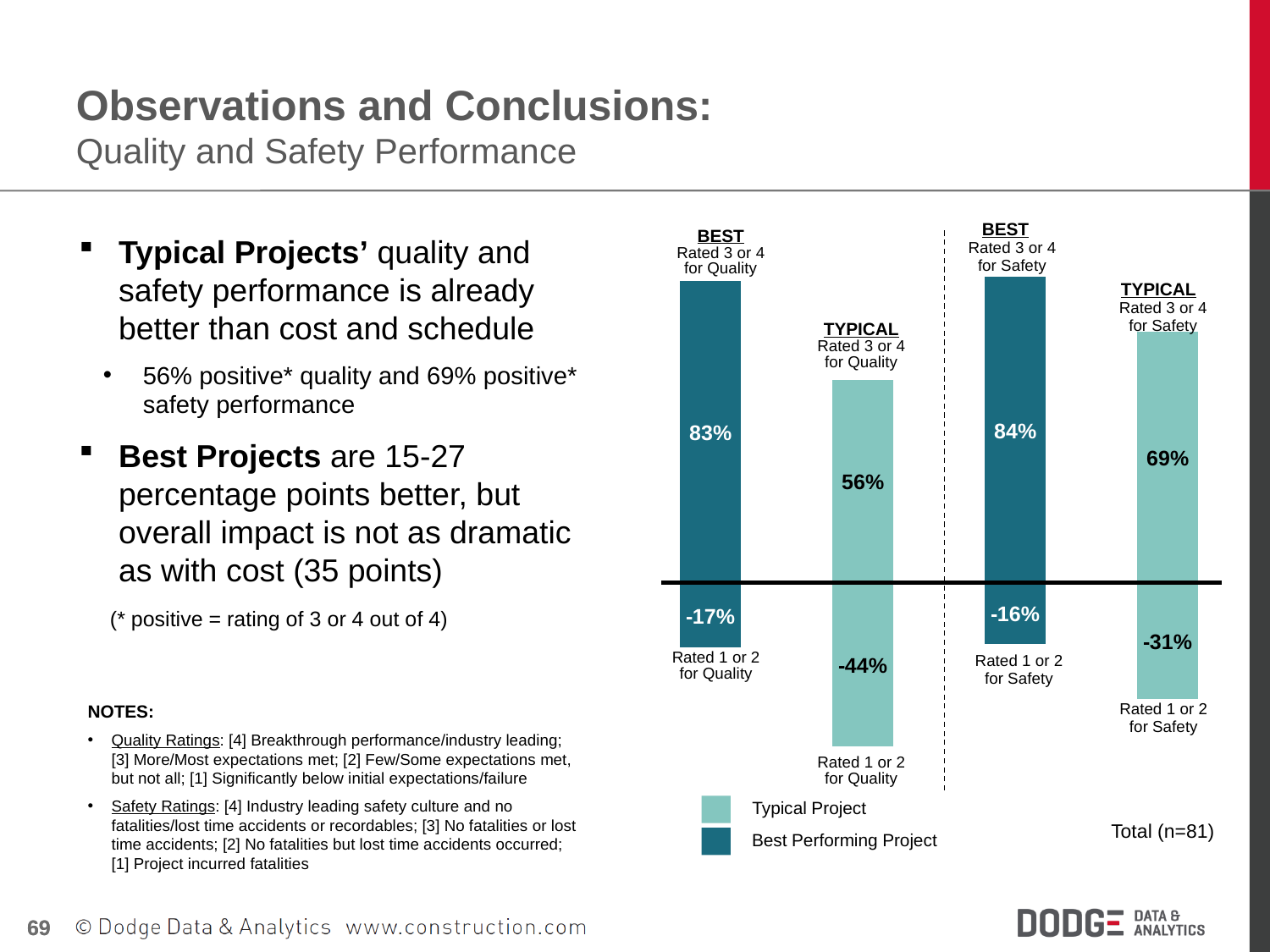
What percentage of Best Performing Projects were rated 3 or 4 for Quality? 83% Which is larger: the percentage of Typical Projects rated 3 or 4 for Safety or for Quality? Safety (69%) Which bar has the highest percentage rated 3 or 4? Best Performing Project for Safety (84%) What is the difference in percentage points between Best Performing and Typical Projects rated 3 or 4 for Quality? 27 percentage points What percentage of Typical Projects were rated 3 or 4 for Quality? 56% How many series does the legend list? 2 What value is shown for Best Performing Projects rated 1 or 2 for Safety? -16% What type of chart is shown on the slide? Bar chart What value is shown for Typical Projects rated 1 or 2 for Quality? -44% What value is shown for Typical Projects rated 1 or 2 for Safety? -31% Which bar has the lowest percentage rated 3 or 4? Typical Project for Quality (56%) What percentage of Best Performing Projects were rated 3 or 4 for Safety? 84%